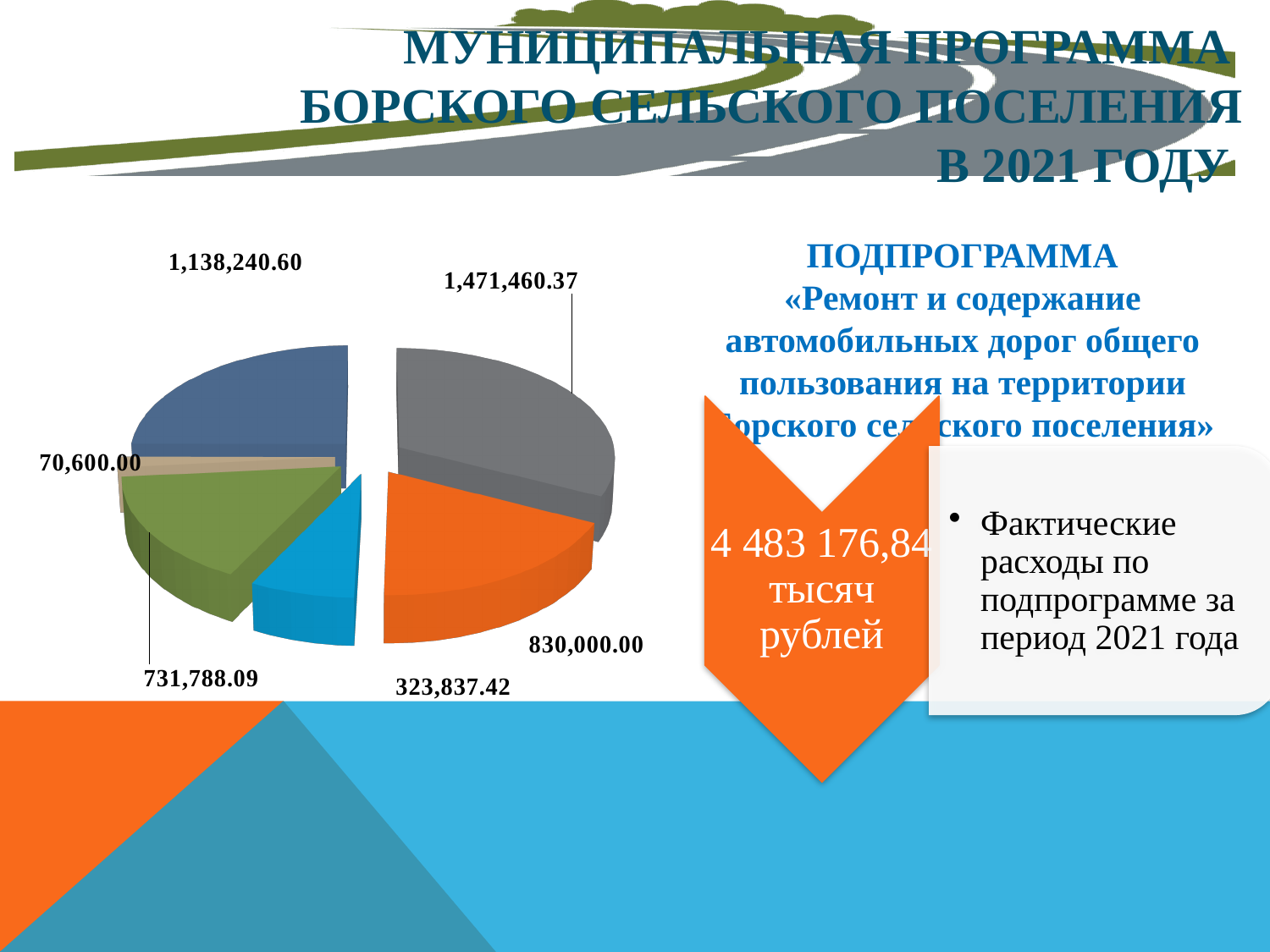
What value is labelled on the dark blue slice of the pie chart? 1,138,240.60 What value is labelled on the orange slice of the pie chart? 830,000.00 What is the smallest value labelled on the pie chart? 70,600.00 What value is labelled on the green slice of the pie chart? 731,788.09 Which slice of the pie chart is larger, the green one or the light blue one? The green one Does the pie chart include a legend naming its slices? No What is the difference between the gray slice (1,471,460.37) and the dark blue slice (1,138,240.60) on the pie chart? 333,219.77 What value is labelled on the light blue slice of the pie chart? 323,837.42 What is the difference between the orange slice (830,000.00) and the light blue slice (323,837.42) on the pie chart? 506,162.58 What kind of chart is shown on the left of the slide? Pie chart What is the largest value labelled on the pie chart? 1,471,460.37 How many slices does the pie chart have? 6